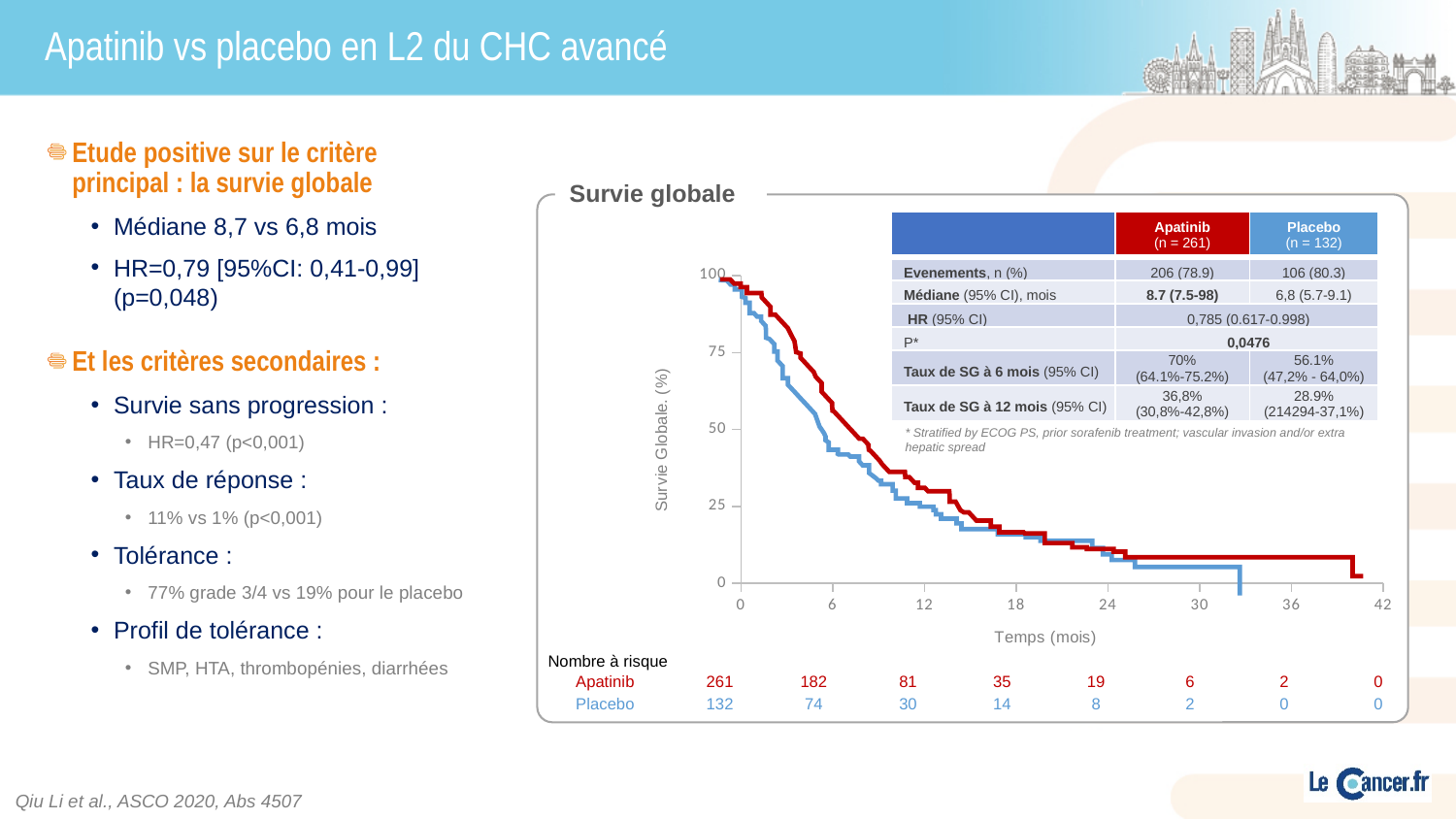
What is the 6-month overall survival rate (Taux de SG à 6 mois) for Apatinib? 70% Do the survival curves rise or fall as time (mois) increases? Fall What is the hazard ratio (HR) shown in the table on the chart? 0,785 In the 'Nombre à risque' table, how many Apatinib patients are at risk at 12 months? 81 In the 'Nombre à risque' table, how many Placebo patients are at risk at 6 months? 74 What is the label of the x axis of the survival chart? Temps (mois) What is the difference between the number of Apatinib and Placebo patients at risk at time 0? 129 What is the 12-month overall survival rate (Taux de SG à 12 mois) for Placebo? 28.9% According to the table on the chart, what is the median overall survival (months) for Placebo? 6,8 According to the table on the chart, what is the median overall survival (months) for Apatinib? 8.7 What is the label of the y axis of the survival chart? Survie Globale (%) What kind of chart is shown under the title 'Survie globale'? Line chart (Kaplan-Meier survival curve)